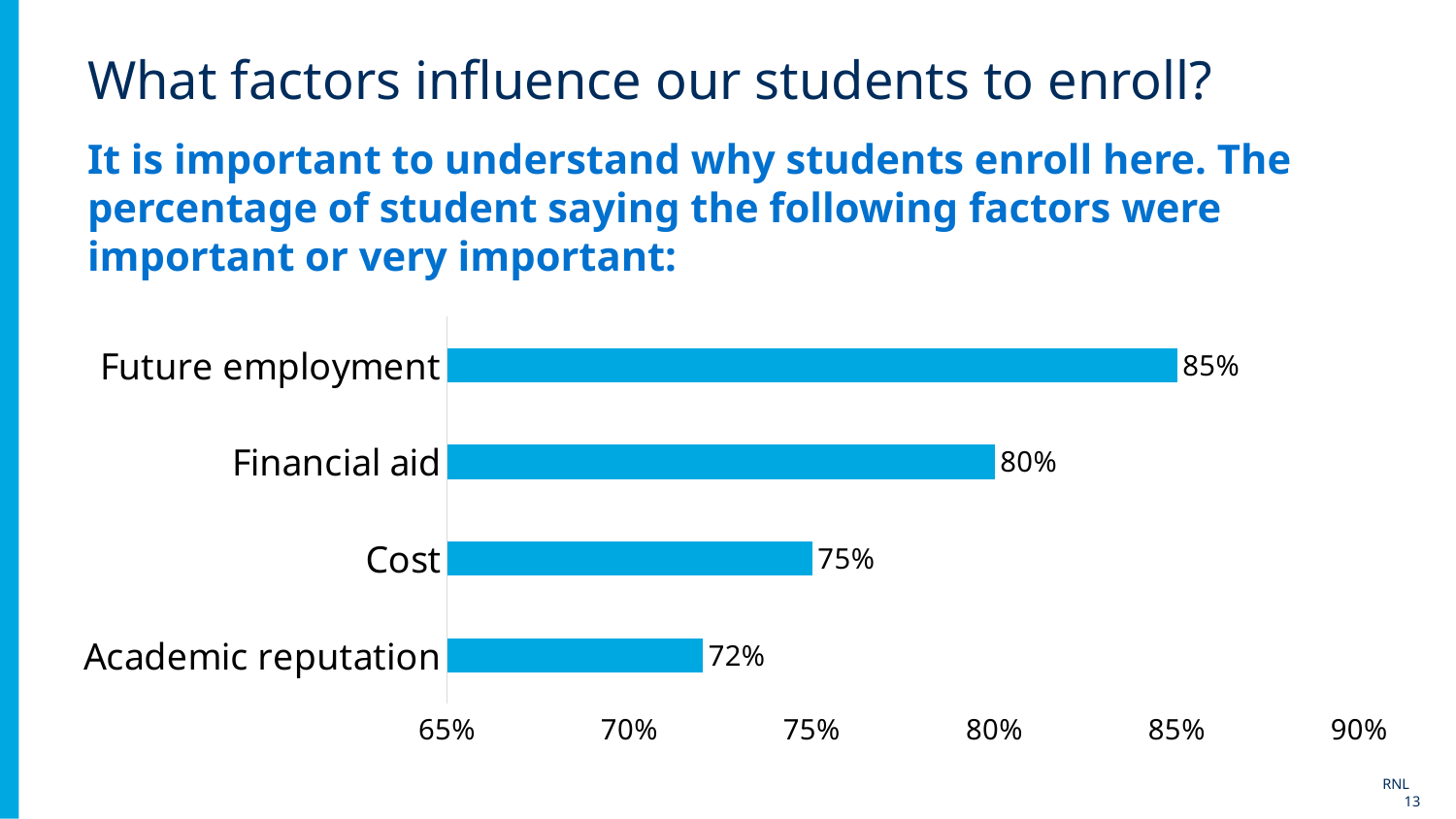
What percentage of students said Future employment was important or very important? 85% What is the value for Financial aid? 80% Which factor has the lowest percentage? Academic reputation What is the lowest value shown on the horizontal axis? 65% Which is larger, the value for Cost or the value for Academic reputation? Cost How many factors are shown in the chart? 4 Which factor has the highest percentage? Future employment What kind of chart is shown on the slide? Bar chart What is the difference between the values for Future employment and Academic reputation? 13% What is the value for Cost? 75% What is the value for Academic reputation? 72% What is the difference between the values for Financial aid and Cost? 5%